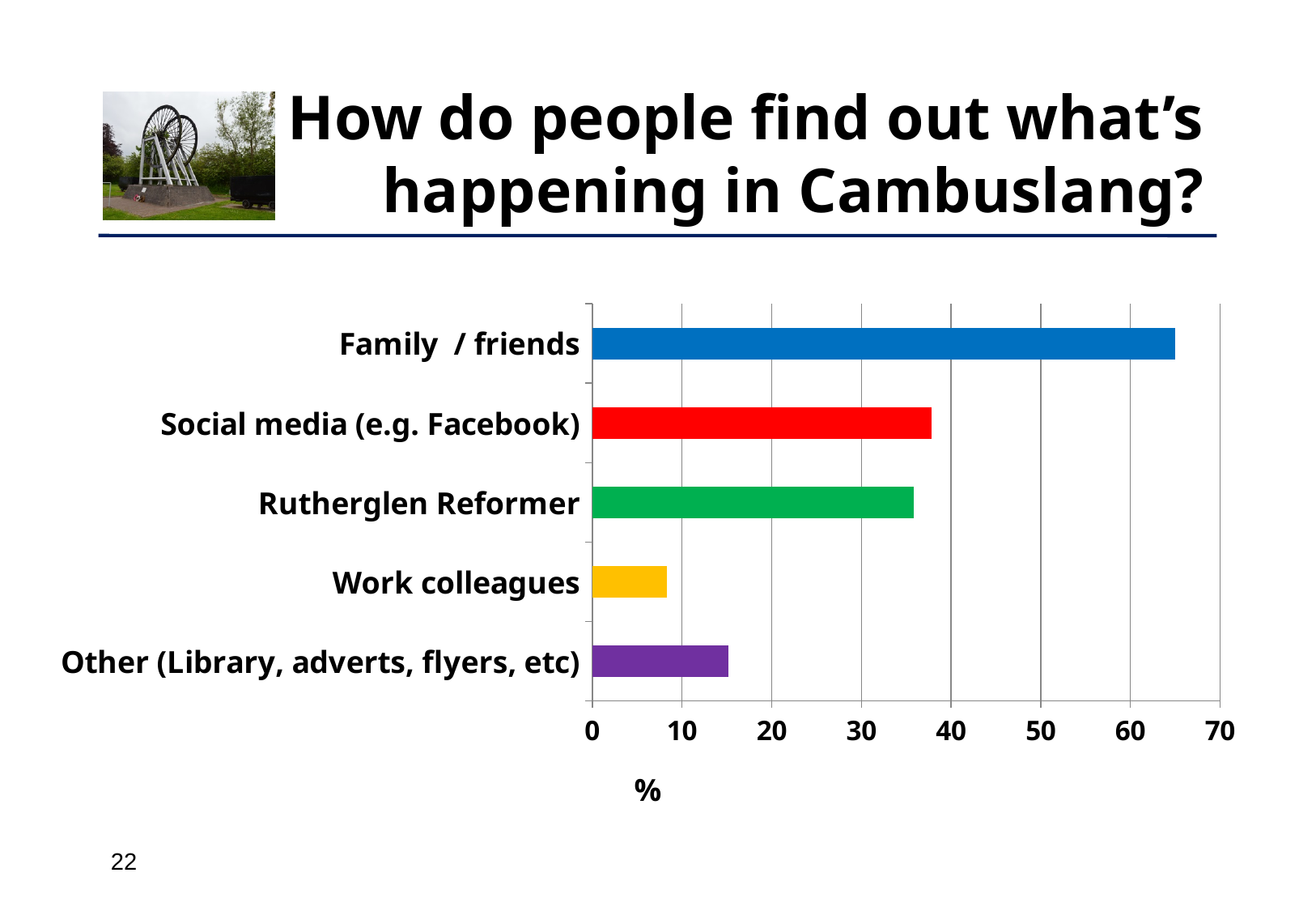
Is the value for Family / friends greater or less than 60? greater Which category has the highest value? Family / friends What is the label on the horizontal axis of the chart? % Is the value for Social media (e.g. Facebook) greater or less than 40? less Is the value for Work colleagues greater or less than 10? less How many categories are shown in the chart? 5 Which is larger, the value for Family / friends or the value for Social media (e.g. Facebook)? Family / friends Which category has the lowest value? Work colleagues Which is larger, the value for Other (Library, adverts, flyers, etc) or the value for Work colleagues? Other (Library, adverts, flyers, etc) What kind of chart is shown on the slide? bar chart